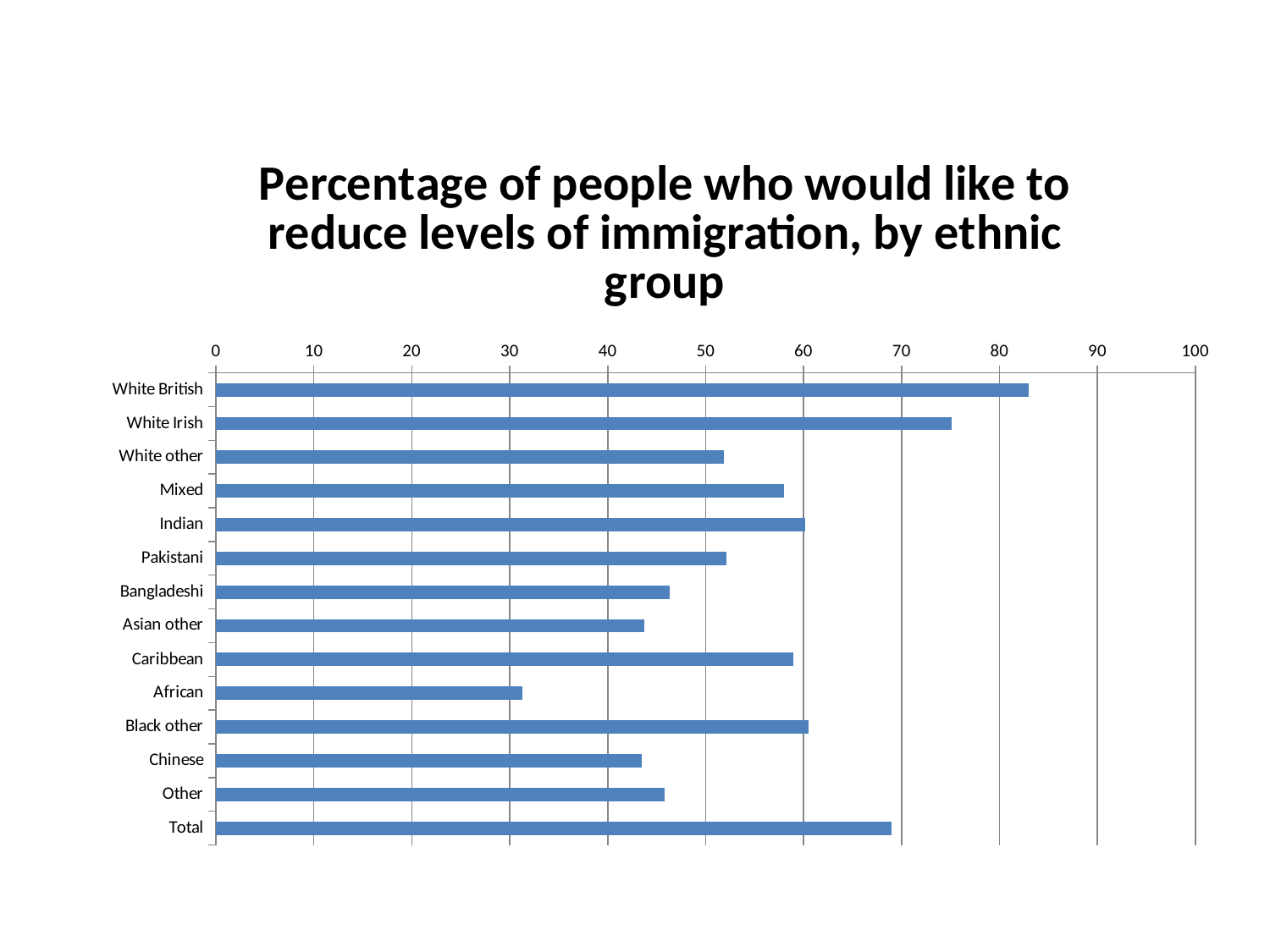
How many categories are plotted on the chart? 14 Is the value for Bangladeshi greater or less than 50? less Which is larger, the value for White Irish or the value for Mixed? White Irish What is the title of the chart? Percentage of people who would like to reduce levels of immigration, by ethnic group Is the value for Total greater or less than 60? greater Which ethnic group has the lowest percentage of people who would like to reduce levels of immigration? African What kind of chart is shown on the slide? bar chart Is the value for African greater or less than 40? less Which ethnic group has the highest percentage of people who would like to reduce levels of immigration? White British Which is larger, the value for Caribbean or the value for Chinese? Caribbean